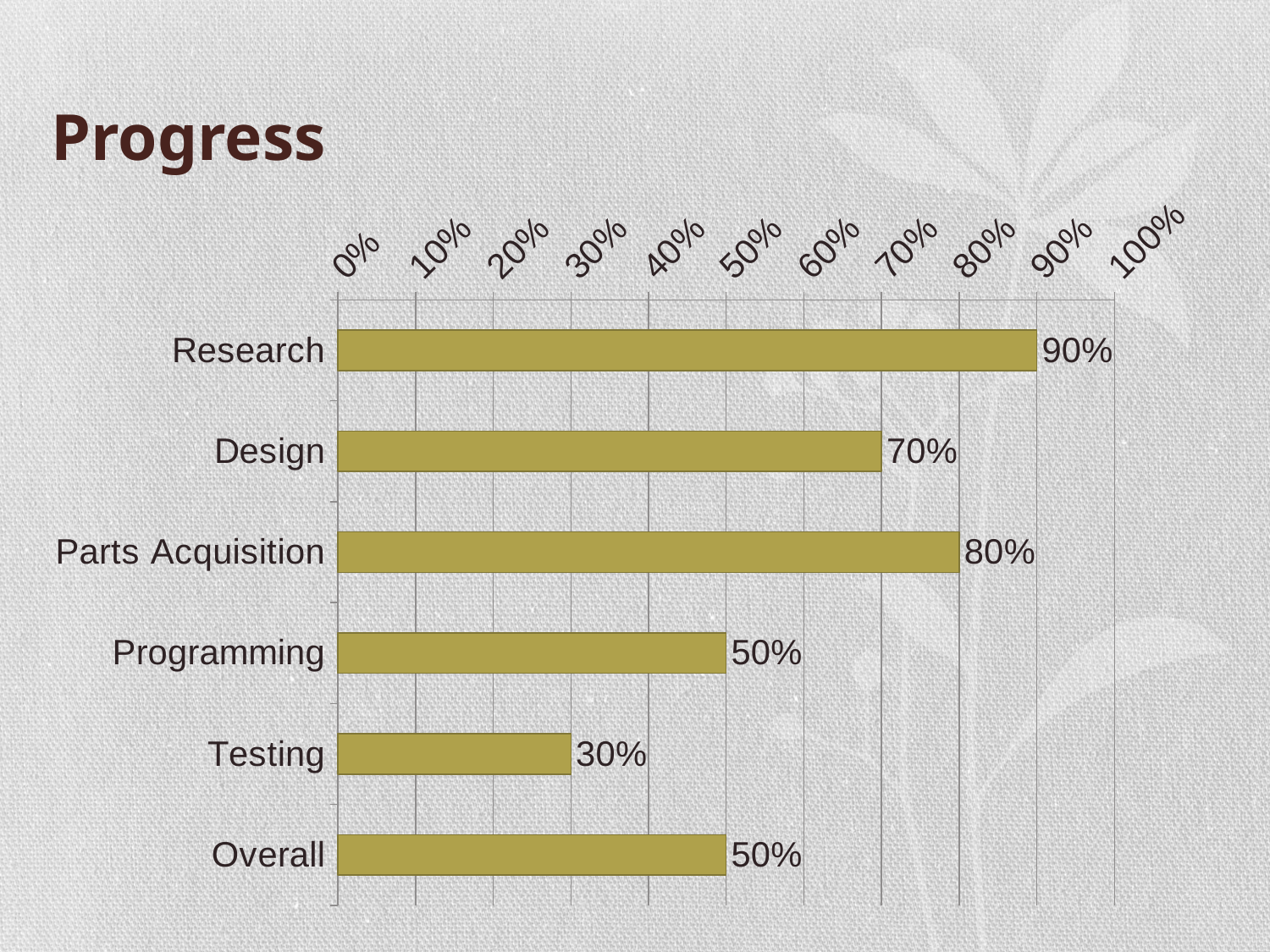
What is the value for Design? 70% What is the title of the slide? Progress Which is larger, the value for Design or the value for Parts Acquisition? Parts Acquisition What is the value for Research? 90% What kind of chart is shown on the slide? Bar chart How many categories are shown in the chart? 6 What is the value for Testing? 30% What is the difference between the values for Research and Design? 20% What is the difference between the values for Parts Acquisition and Testing? 50% What is the value for Parts Acquisition? 80% Which category has the highest value? Research Which category has the lowest value? Testing